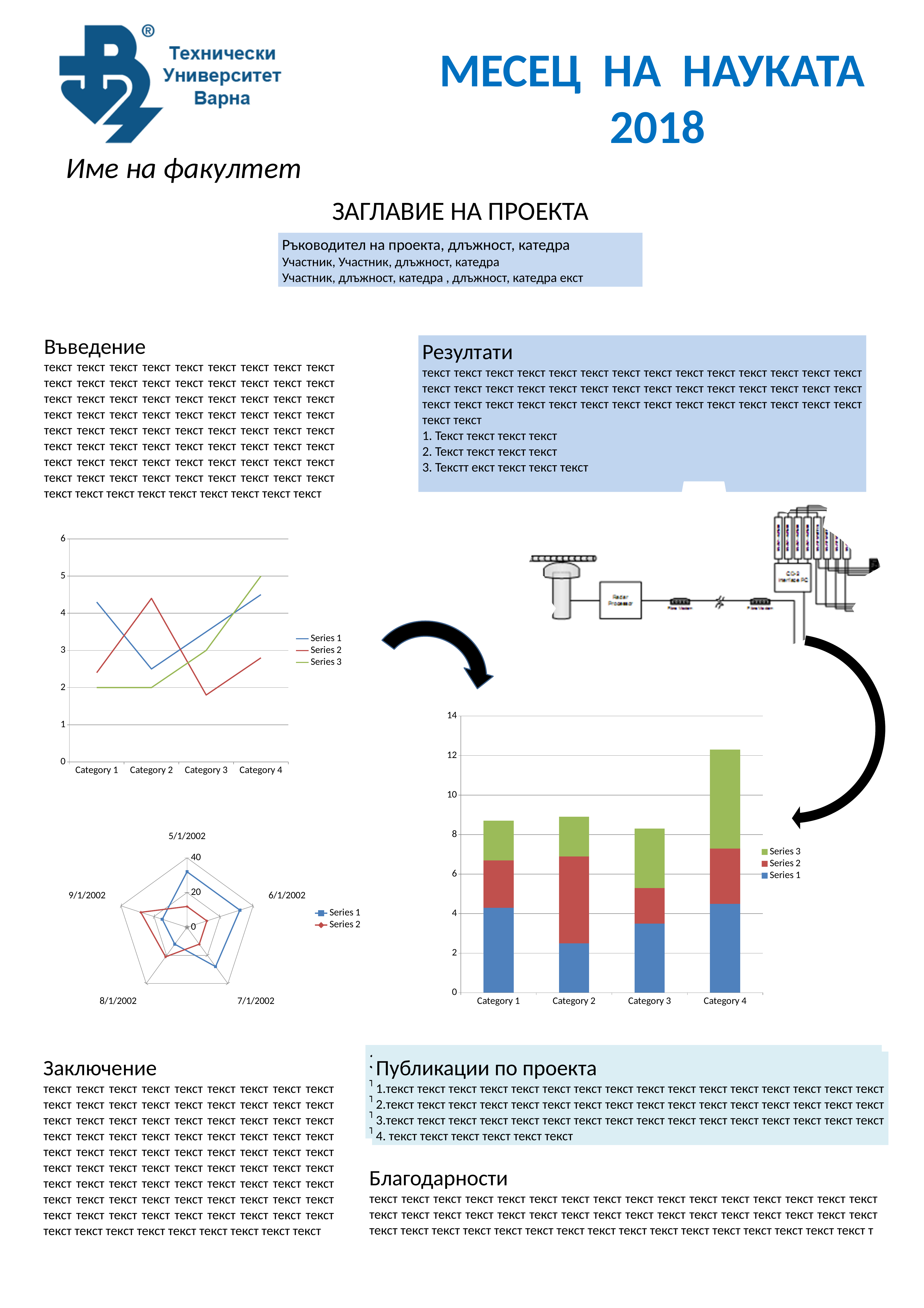
In the top-left line chart, does Series 3 rise or fall from Category 1 to Category 4? rise In the top-left line chart, which series has the larger value at Category 2, Series 1 or Series 2? Series 2 In the stacked bar chart on the right, which category has the tallest bar? Category 4 What kind of chart is the top-left chart with Category 1 to Category 4 on the x axis? line chart What kind of chart is the chart on the right with a y axis from 0 to 14? stacked bar chart In the top-left line chart, is the value of Series 3 at Category 4 greater or less than 4? greater What kind of chart is the bottom-left chart with dates such as 5/1/2002 around its edge? radar chart How many axis points (dates) does the bottom-left radar chart have? 5 How many series does the legend of the bottom-left radar chart list? 2 How many series does the legend of the top-left line chart list? 3 How many categories are shown on the x axis of the top-left line chart? 4 In the top-left line chart, is the value of Series 2 at Category 3 greater or less than 2? less